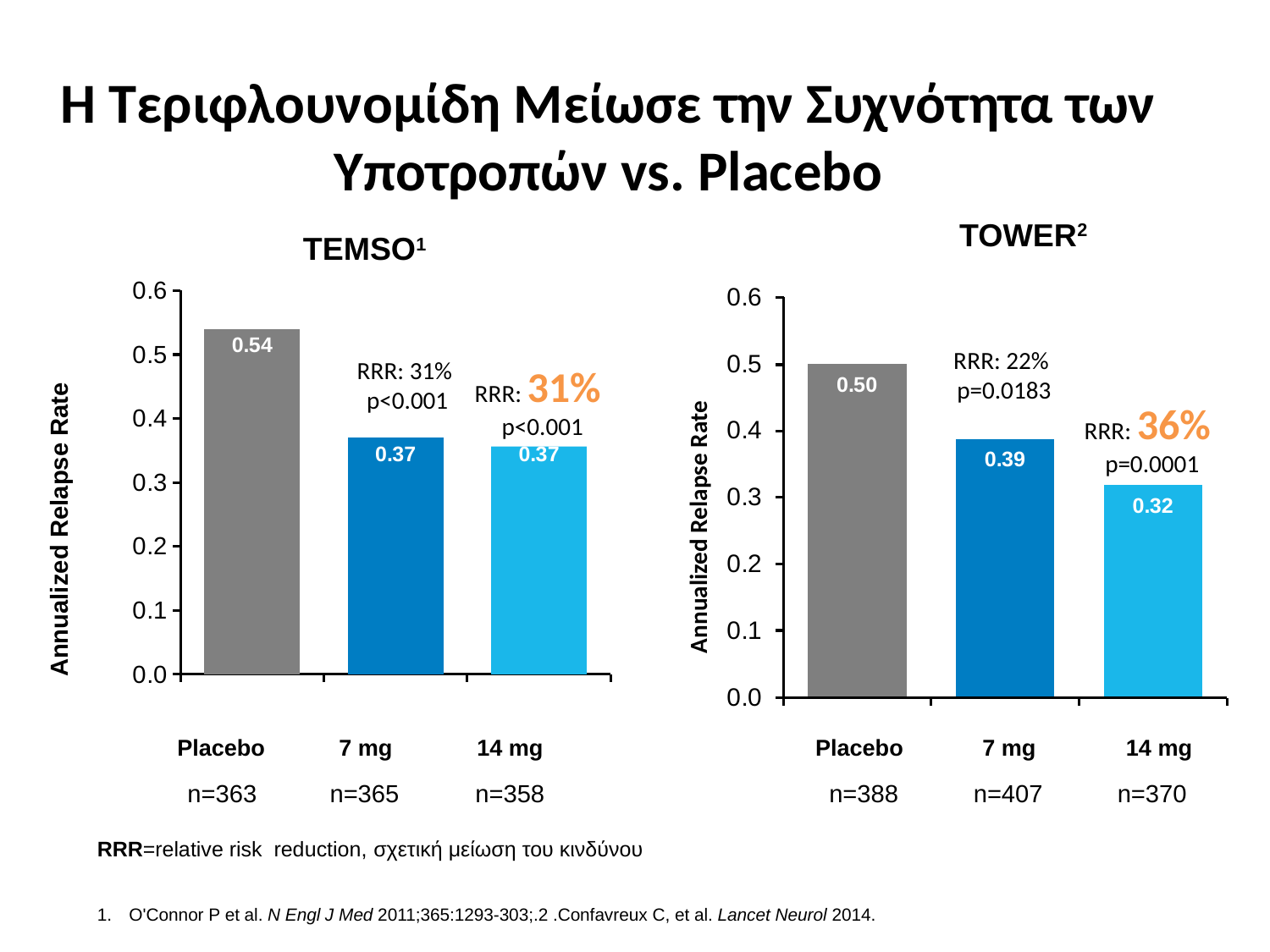
In the TEMSO chart, what is the annualized relapse rate for 14 mg? 0.37 In the TOWER chart, what is the annualized relapse rate for 14 mg? 0.32 In the TOWER chart, which is larger, the annualized relapse rate for 7 mg or for 14 mg? 7 mg In the TEMSO chart, which group has the highest annualized relapse rate? Placebo In the TOWER chart, what is the difference in annualized relapse rate between Placebo and 14 mg? 0.18 In the TEMSO chart, what is the difference in annualized relapse rate between Placebo and 7 mg? 0.17 In the TOWER chart, which group has the lowest annualized relapse rate? 14 mg What type of chart is the TOWER chart? Bar chart How many groups are shown in the TEMSO chart? 3 What is the y-axis label of the TEMSO chart? Annualized Relapse Rate In the TOWER chart, what is the annualized relapse rate for 7 mg? 0.39 In the TEMSO chart, what is the annualized relapse rate for Placebo? 0.54